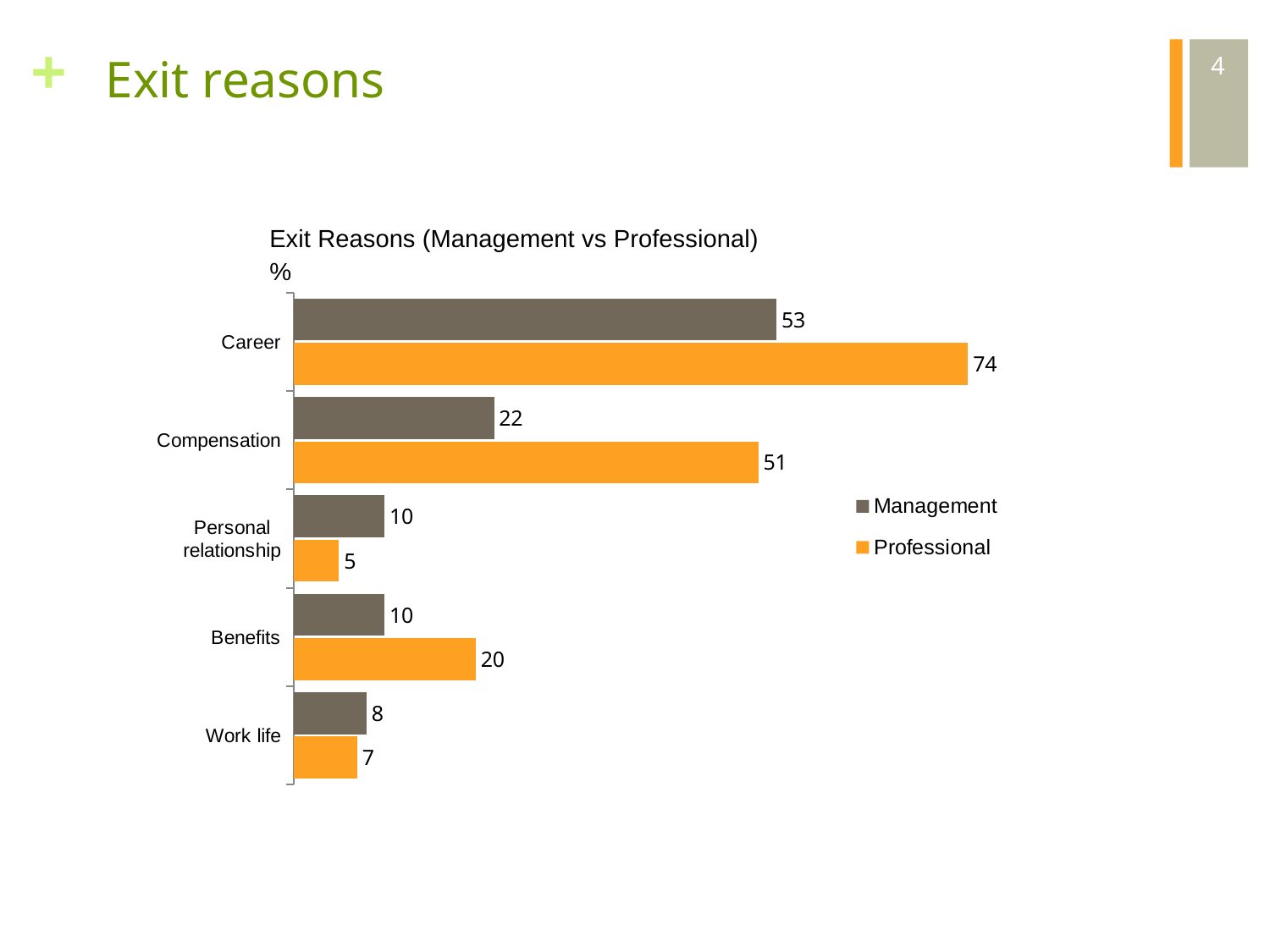
Which category has the highest Professional value? Career What is the Management value for Compensation? 22 What is the difference between the Professional and Management values for Compensation? 29 What is the Professional value for Benefits? 20 Which category has the lowest Professional value? Personal relationship What is the title of the chart? Exit Reasons (Management vs Professional) For Personal relationship, which is larger: the Management value or the Professional value? Management What kind of chart is shown? Bar chart What is the Management value for Work life? 8 How many categories are shown on the chart? 5 What is the Professional value for Career? 74 How many series does the legend list? 2